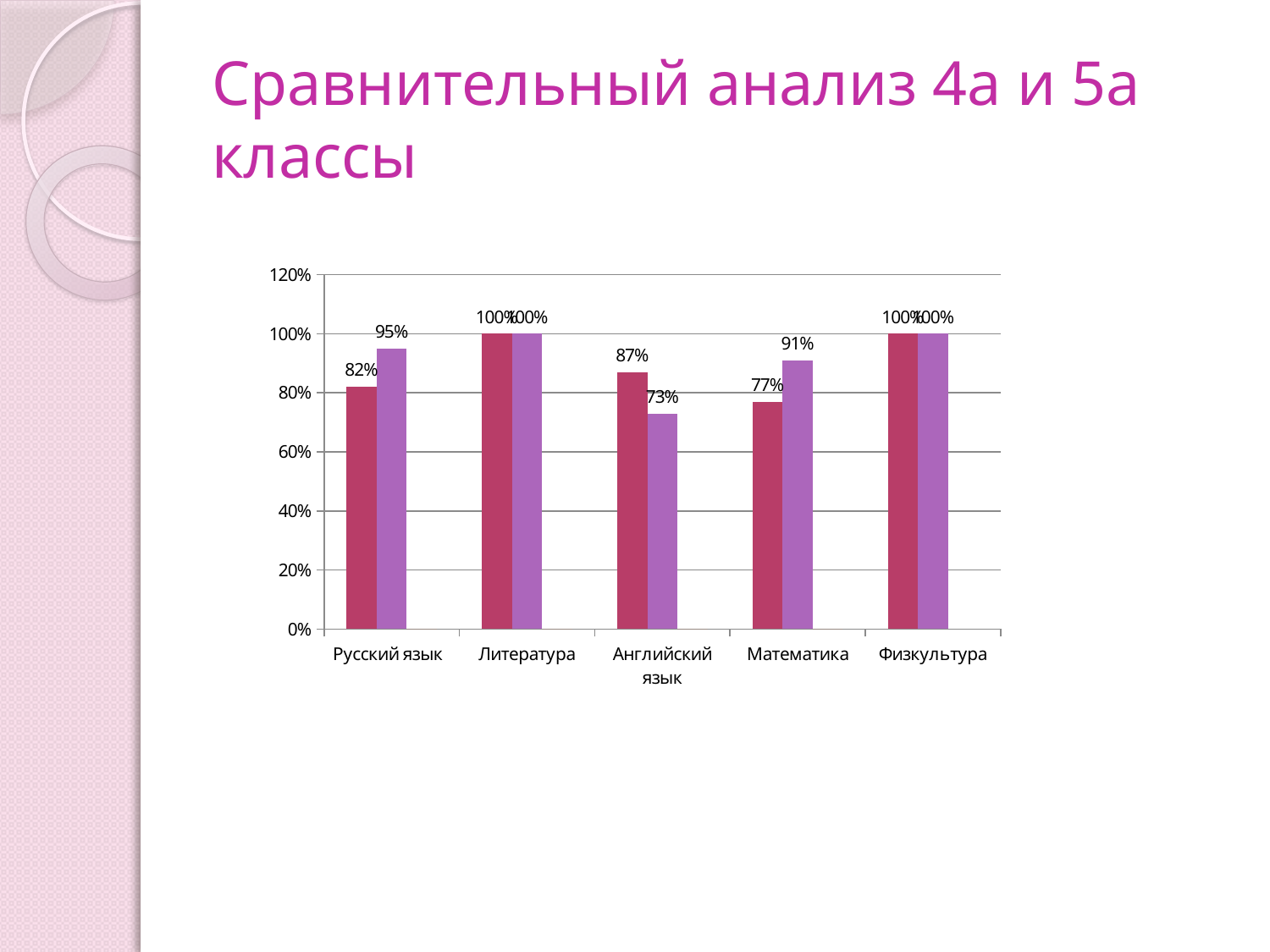
How many categories are shown on the x axis? 5 Which category has the lowest value among the purple (right) bars? Английский язык What is the value of the dark red (left) bar for Математика? 77% For Английский язык, which bar is larger, the dark red (left) or the purple (right)? dark red (left) What is the value of the purple (right) bar for Математика? 91% What type of chart is shown on the slide? bar chart What is the value of the purple (right) bar for Английский язык? 73% Which category has the lowest value among the dark red (left) bars? Математика What is the difference between the purple bar and the dark red bar for Русский язык? 13% What is the title of the slide? Сравнительный анализ 4а и 5а классы What is the value of the purple (right) bar for Русский язык? 95% What is the value of the dark red (left) bar for Русский язык? 82%